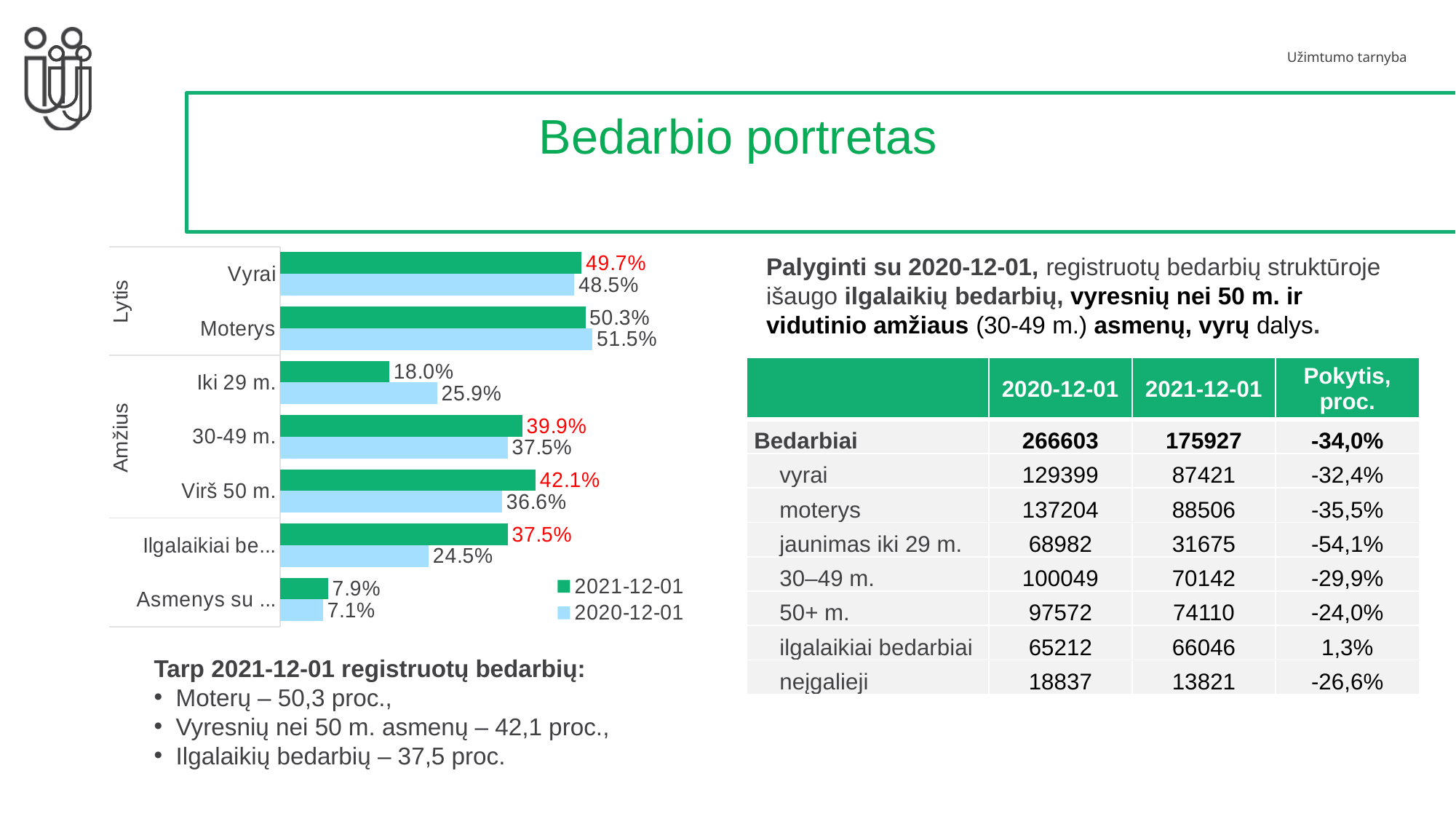
What is the value for Iki 29 m. in the 2020-12-01 series? 25.9% What is the value for Vyrai in the 2021-12-01 series? 49.7% What is the difference between the 2021-12-01 and 2020-12-01 values for Virš 50 m.? 5.5% What is the difference between the 2021-12-01 and 2020-12-01 values for Iki 29 m.? 7.9% Which series is shown in green in the chart? 2021-12-01 What is the value for Virš 50 m. in the 2021-12-01 series? 42.1% What kind of chart is shown on the slide? bar chart What is the value for Moterys in the 2020-12-01 series? 51.5% How many series does the chart legend list? 2 For 30-49 m., which series has the larger value, 2021-12-01 or 2020-12-01? 2021-12-01 Which category has the lowest value in the 2020-12-01 series? Asmenys su ... Which category has the highest value in the 2021-12-01 series? Moterys